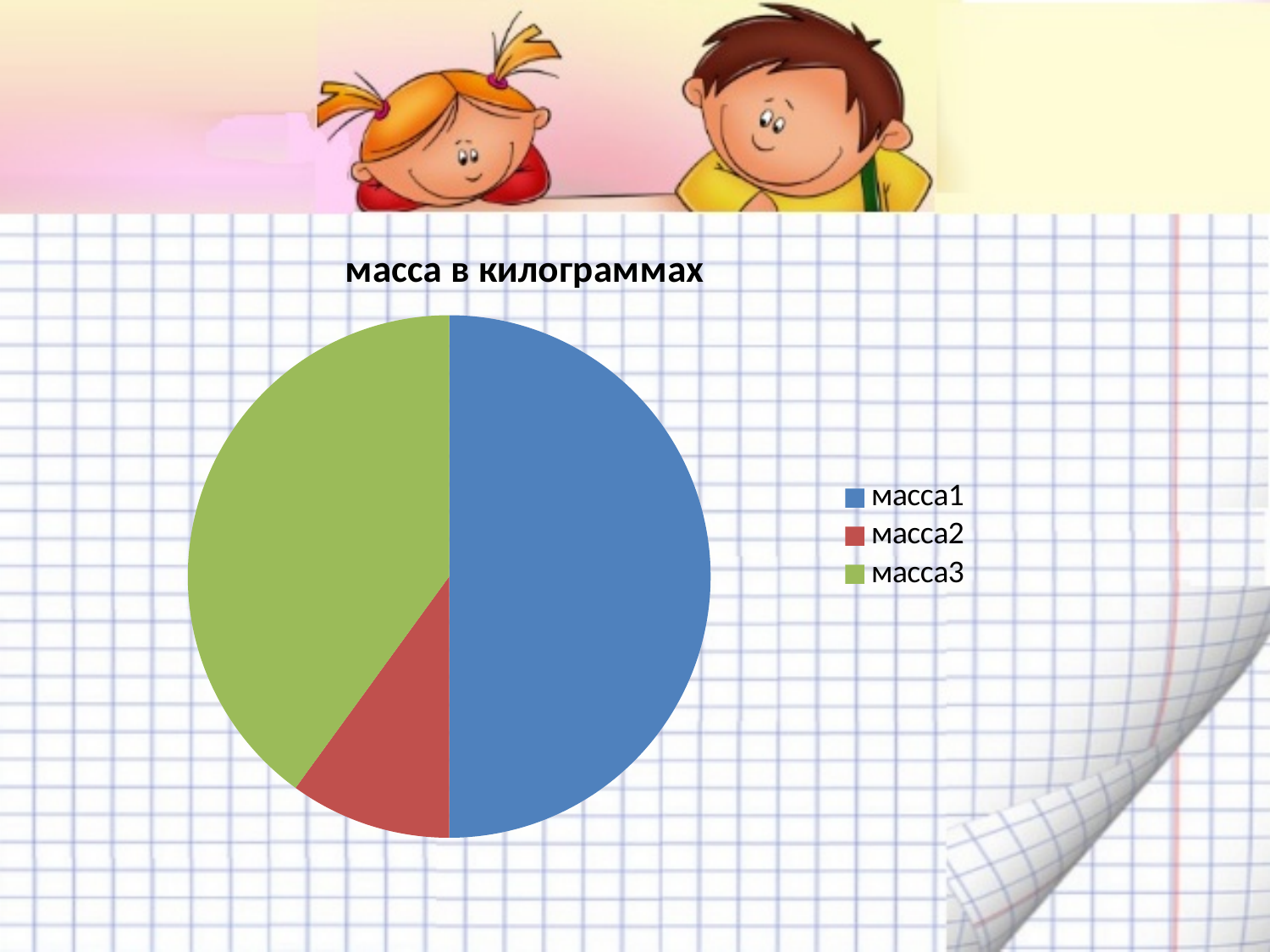
What kind of chart is shown on the slide? pie chart Which category has the largest slice of the pie? масса1 How many slices does the pie chart have? 3 Which is larger, the slice for масса1 or the slice for масса2? масса1 Which is larger, the slice for масса1 or the slice for масса3? масса1 Which category has the smallest slice of the pie? масса2 Which is larger, the slice for масса3 or the slice for масса2? масса3 What colour is the slice for масса3? green How many entries does the legend list? 3 What is the title of the chart? масса в килограммах